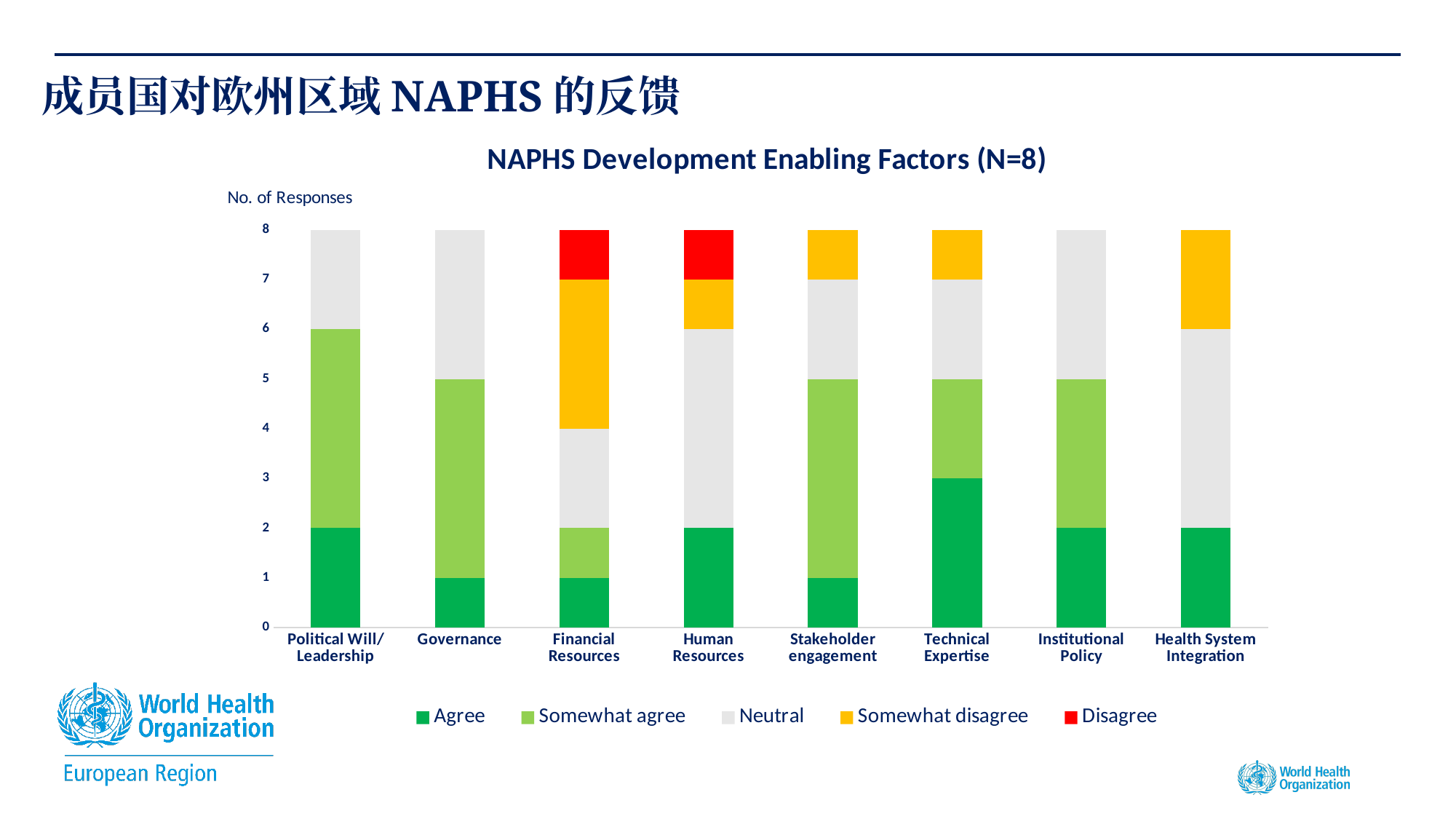
Which enabling factor has the highest number of 'Agree' responses? Technical Expertise How many enabling factors (categories) are shown on the x axis? 8 What is the difference between the 'Agree' responses for Technical Expertise and Governance? 2 What kind of chart is shown on the slide? Stacked bar chart Which enabling factors have any 'Disagree' responses? Financial Resources and Human Resources How many 'Somewhat disagree' responses does Financial Resources have? 3 How many series does the legend list? 5 What is the total number of responses in the Governance bar? 8 How many 'Agree' responses does Technical Expertise have? 3 What is the title of the chart? NAPHS Development Enabling Factors (N=8) Which has more 'Somewhat agree' responses, Political Will/Leadership or Institutional Policy? Political Will/Leadership How many 'Neutral' responses does Human Resources have? 4